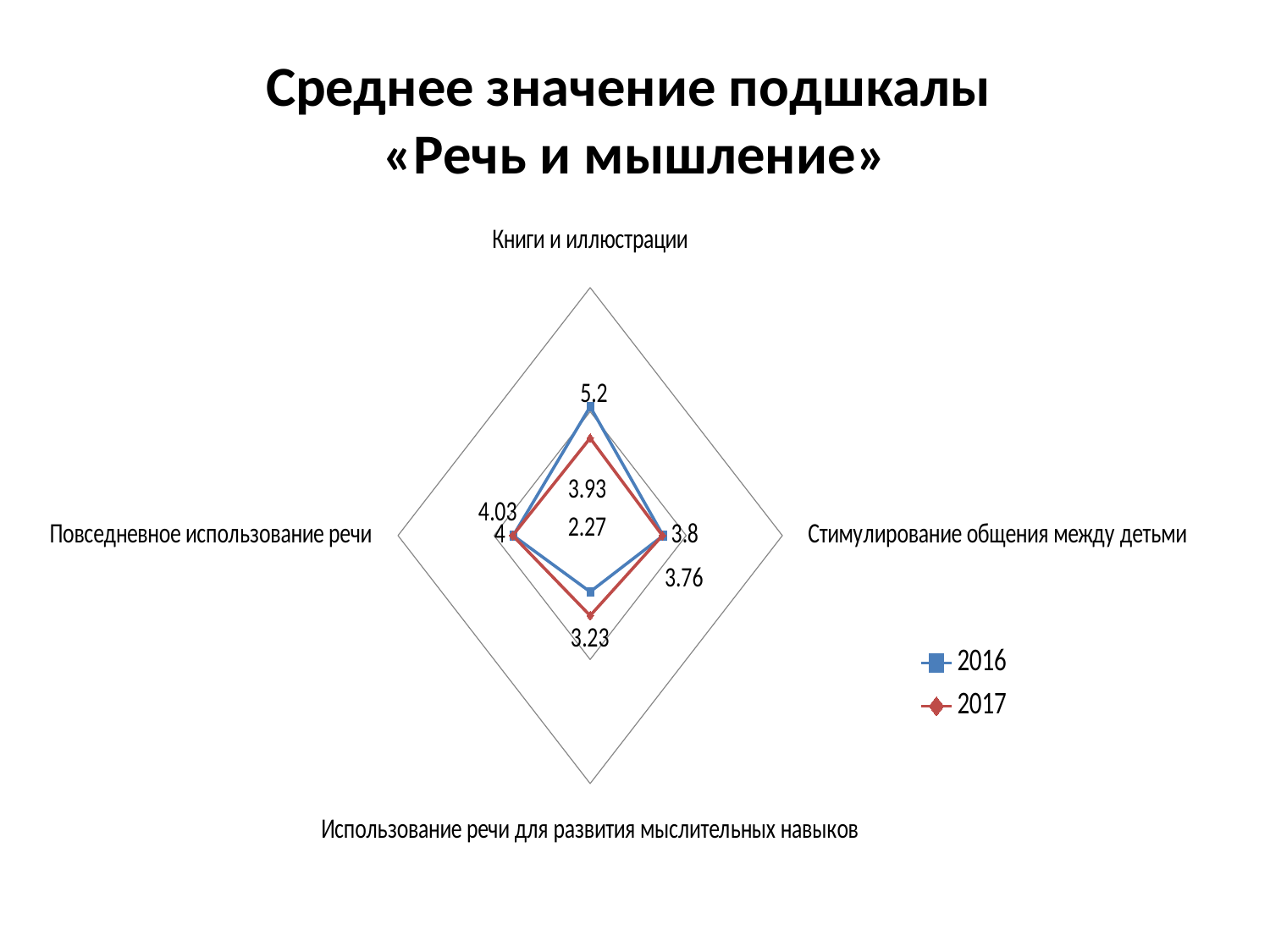
Which category has the lowest 2016 value? Использование речи для развития мыслительных навыков What kind of chart is shown on the slide? radar chart What is the 2016 value for Использование речи для развития мыслительных навыков? 2.27 Which category has the highest 2016 value? Книги и иллюстрации What is the 2016 value for Книги и иллюстрации? 5.2 What is the difference between the 2016 and 2017 values for Книги и иллюстрации? 1.27 How many series does the legend list? 2 For Использование речи для развития мыслительных навыков, which year has the larger value, 2016 or 2017? 2017 How many categories (axes) does the radar chart have? 4 What is the 2017 value for Использование речи для развития мыслительных навыков? 3.23 What is the 2017 value for Книги и иллюстрации? 3.93 What is the 2016 value for Повседневное использование речи? 4